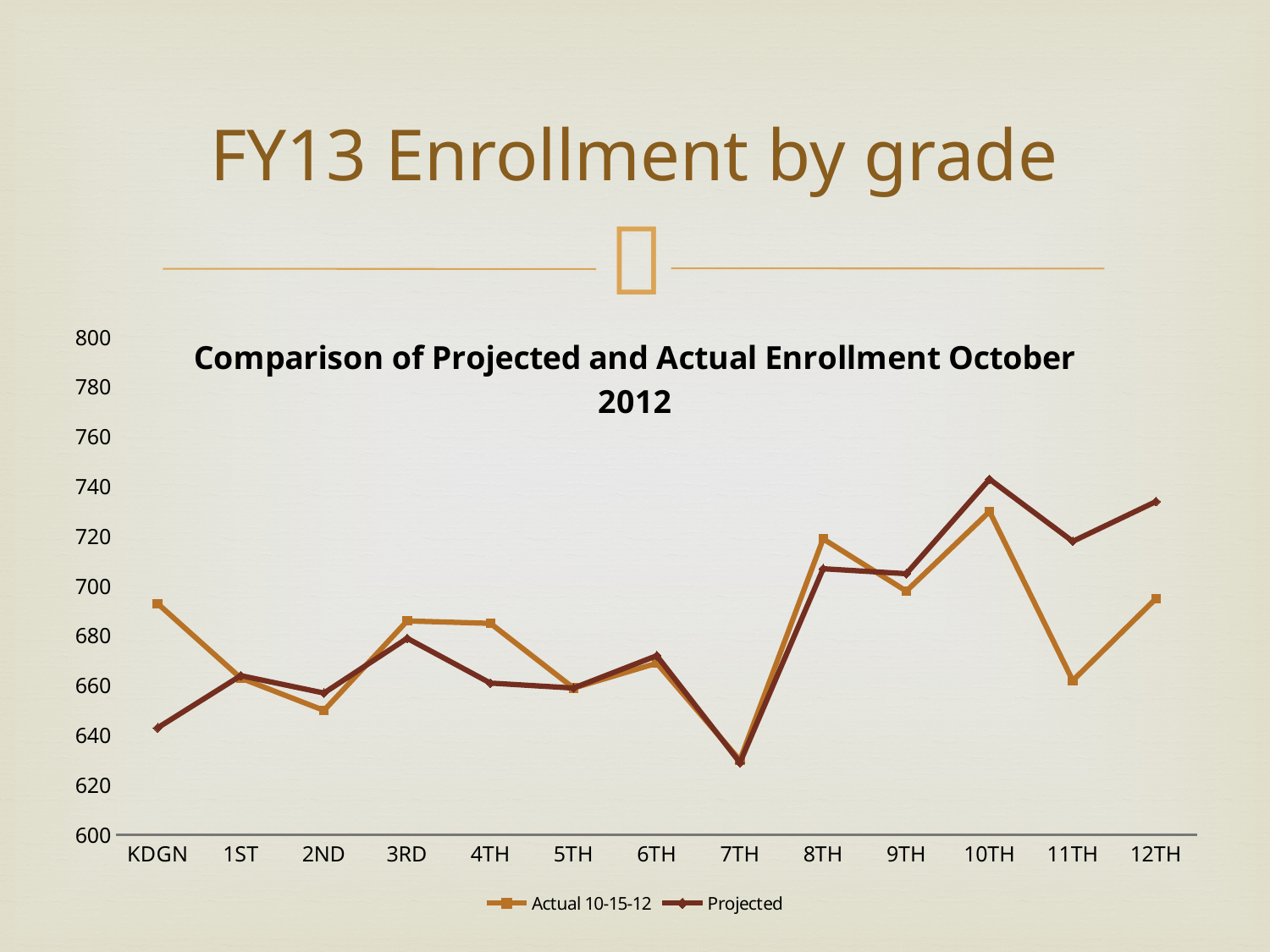
How many series does the legend list? 2 Is the Projected value for KDGN greater or less than 660? less For which grade is the Projected enrollment highest? 10TH What are the two series named in the legend? Actual 10-15-12 and Projected What is the title of the chart? Comparison of Projected and Actual Enrollment October 2012 At 12TH grade, which series has the higher value, Actual 10-15-12 or Projected? Projected At KDGN, which series has the higher value, Actual 10-15-12 or Projected? Actual 10-15-12 For which grade is the Projected enrollment lowest? 7TH How many grade categories are shown on the x axis? 13 What type of chart is shown on the slide? line chart For which grade is the Actual 10-15-12 enrollment lowest? 7TH Is the Actual 10-15-12 value for KDGN greater or less than 680? greater